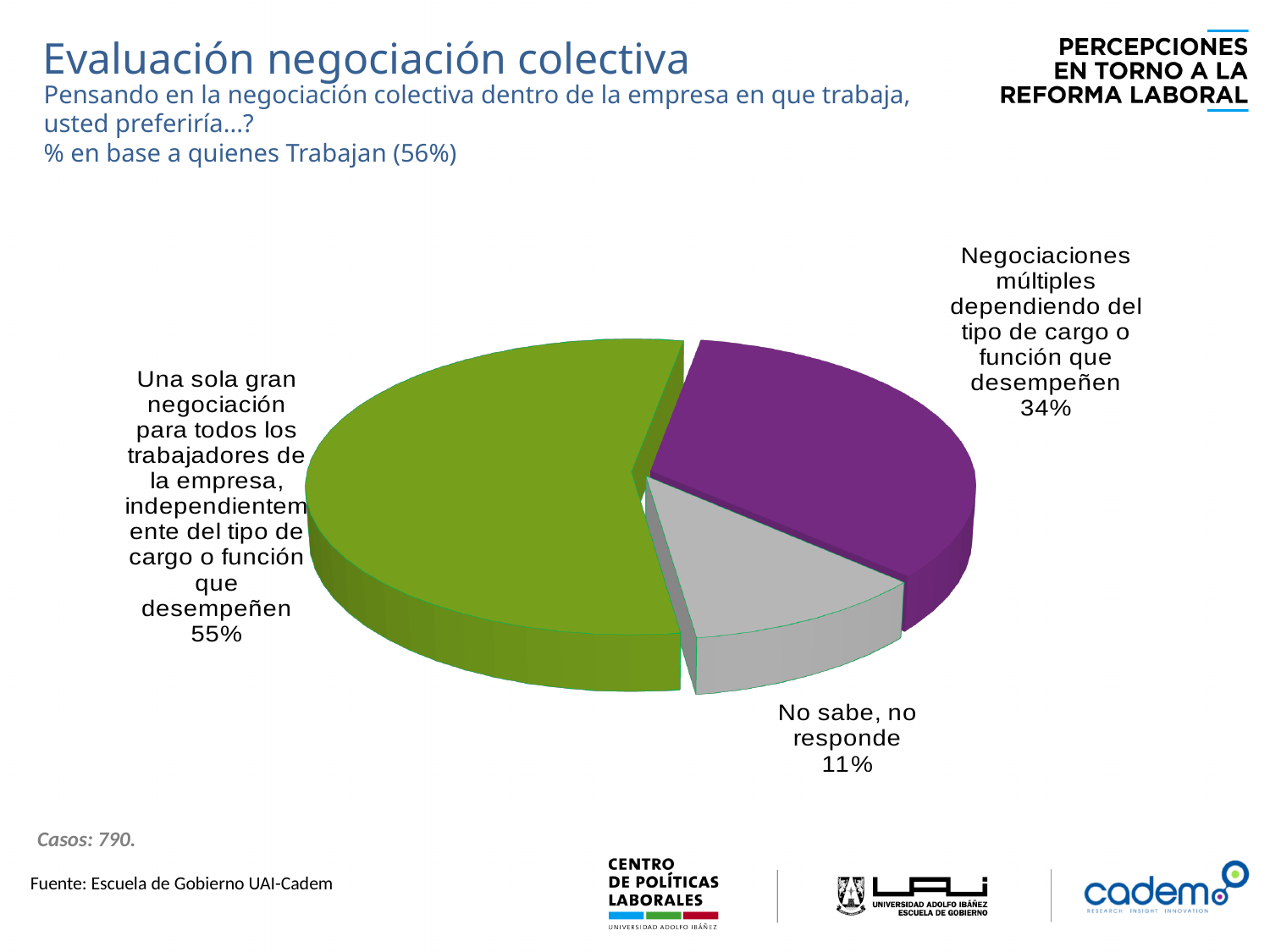
How many cases (Casos) does the slide report for this chart? 790 How many slices does the pie chart have? 3 What percentage of respondents prefer 'Negociaciones múltiples dependiendo del tipo de cargo o función que desempeñen'? 34% What percentage of respondents prefer 'Una sola gran negociación para todos los trabajadores de la empresa'? 55% Which is larger: the share for 'Negociaciones múltiples' or the share for 'No sabe, no responde'? Negociaciones múltiples What percentage corresponds to 'No sabe, no responde'? 11% What share of the pie does the 'No sabe, no responde' slice represent? 11% What kind of chart is shown on the slide? pie chart Which option has the largest share of the pie? Una sola gran negociación para todos los trabajadores de la empresa Which category has the smallest slice of the pie? No sabe, no responde What colour is the slice for 'Una sola gran negociación para todos los trabajadores de la empresa'? green What is the difference in percentage points between 'Una sola gran negociación' and 'Negociaciones múltiples'? 21